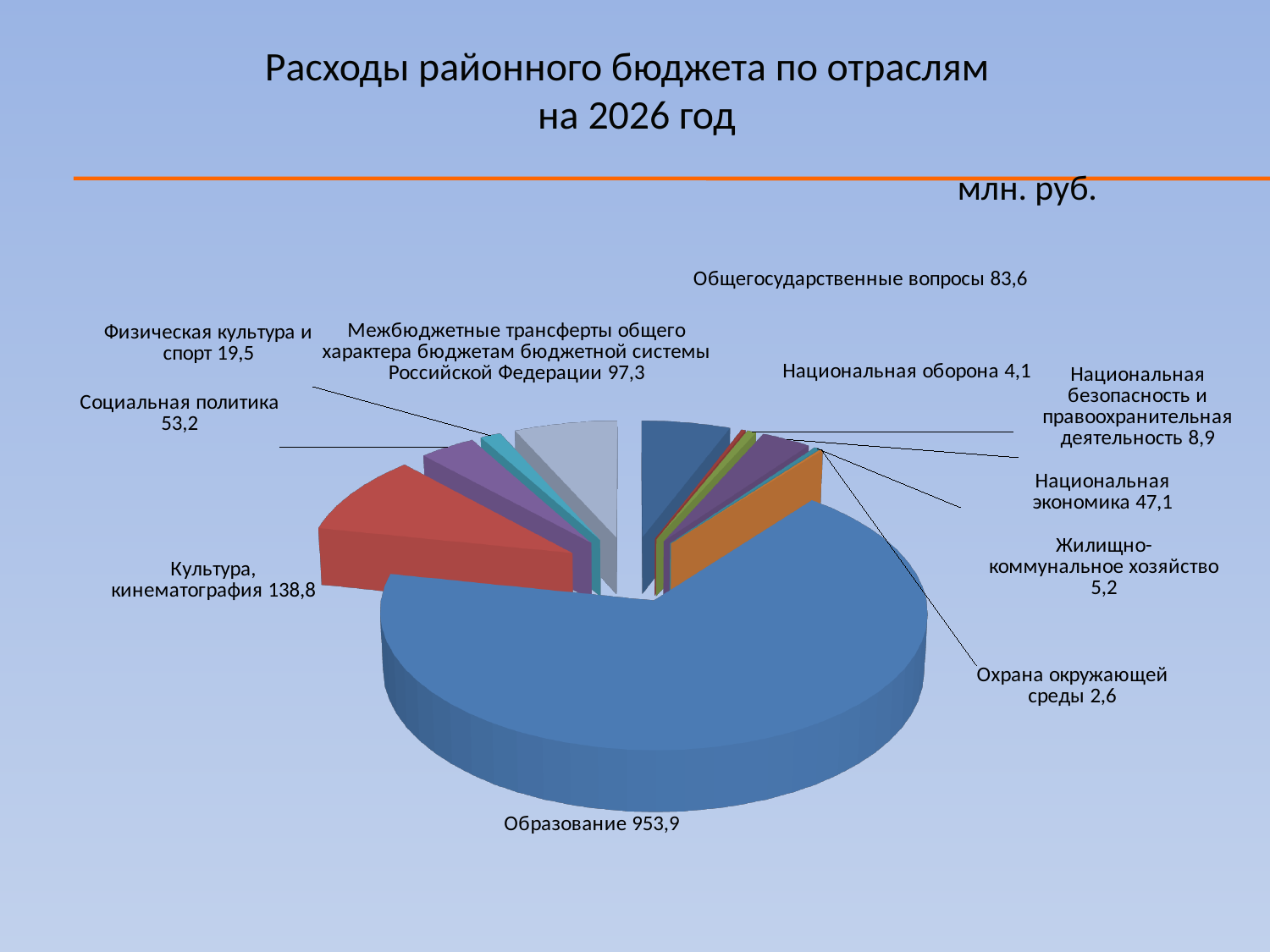
What type of chart is shown on the slide? Pie chart What is the value for Образование? 953,9 What is the difference between Образование and Культура, кинематография? 815,1 Which category has the smallest value? Охрана окружающей среды Which category has the largest value? Образование What unit is indicated for the values on the slide? млн. руб. What is the value for Культура, кинематография? 138,8 Which is larger: Социальная политика or Физическая культура и спорт? Социальная политика What is the value for Национальная экономика? 47,1 How many categories are shown in the pie chart? 11 What is the value for Межбюджетные трансферты общего характера бюджетам бюджетной системы Российской Федерации? 97,3 What is the difference between Общегосударственные вопросы and Национальная экономика? 36,5